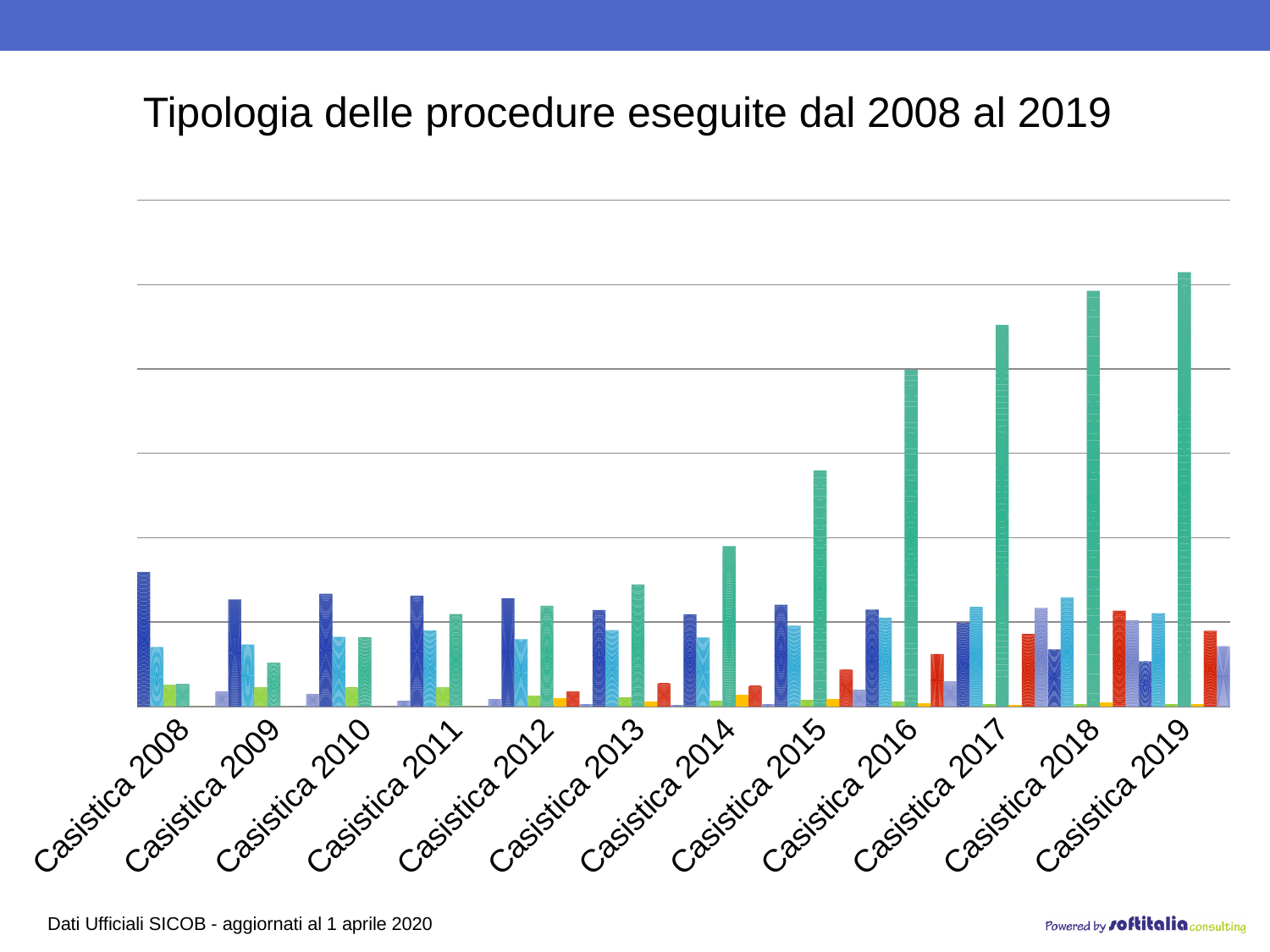
Which category contains the tallest bar in the chart? Casistica 2019 What is the title of the chart on the slide? Tipologia delle procedure eseguite dal 2008 al 2019 How many categories are shown along the x axis of the chart? 12 What kind of chart is shown on the slide? bar chart Does the tallest (teal) series rise or fall from Casistica 2009 to Casistica 2019? rise Which category has the taller tallest bar, Casistica 2017 or Casistica 2018? Casistica 2018 Which category has the taller tallest bar, Casistica 2013 or Casistica 2014? Casistica 2014 Does the chart display a legend identifying the series? No Which category has the taller tallest bar, Casistica 2008 or Casistica 2019? Casistica 2019